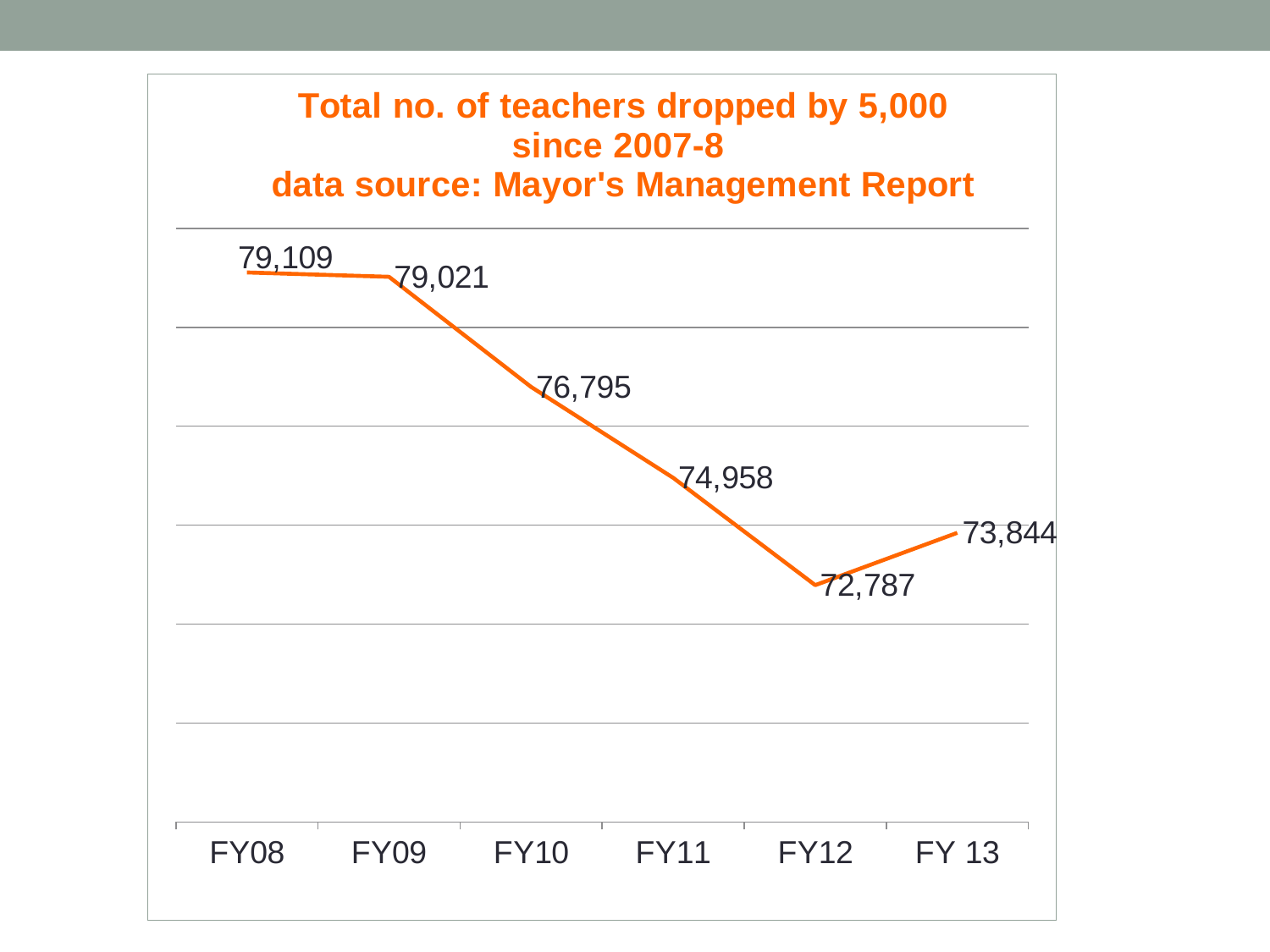
What is the total number of teachers in FY12? 72,787 Which fiscal year has the highest number of teachers? FY08 What is the total number of teachers in FY 13? 73,844 What is the overall trend in the number of teachers from FY08 to FY12? Falling What is the difference in the number of teachers between FY10 and FY11? 1,837 What is the difference in the number of teachers between FY08 and FY12? 6,322 Which year has more teachers, FY11 or FY 13? FY11 How many fiscal years are plotted on the chart? 6 What is the total number of teachers in FY10? 76,795 What is the total number of teachers in FY08? 79,109 What kind of chart is shown on the slide? Line chart Which fiscal year has the lowest number of teachers? FY12